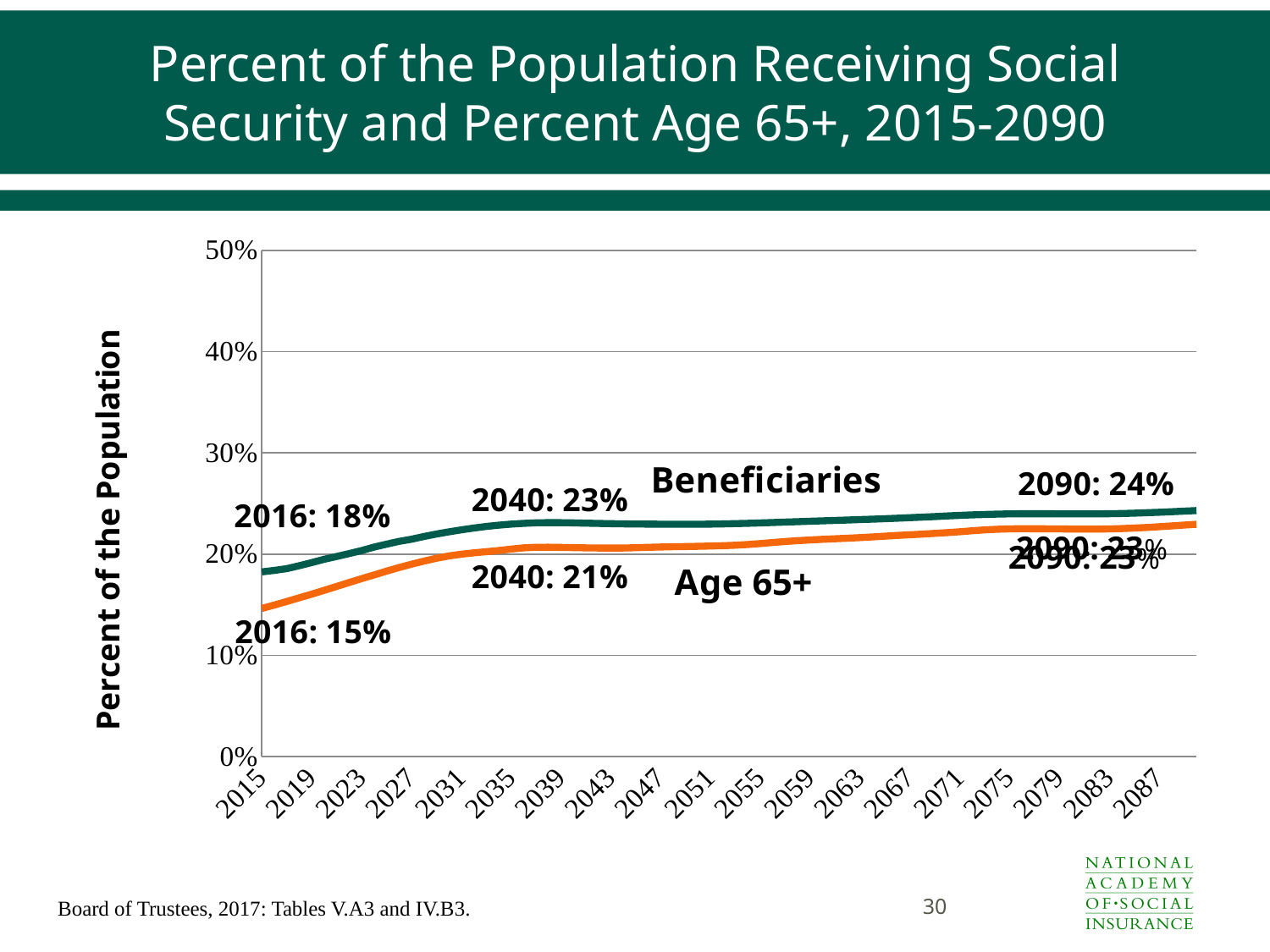
What kind of chart is shown on the slide? line chart What percent of the population was Age 65+ in 2016? 15% What percent of the population were Beneficiaries in 2016? 18% Is the value for Age 65+ in 2087 greater or less than 20%? greater What value is labeled for Beneficiaries in 2040? 23% By how many percentage points did Beneficiaries exceed Age 65+ in 2016? 3 percentage points Does the Beneficiaries line generally rise or fall from 2015 to 2090? rise By how many percentage points did Beneficiaries exceed Age 65+ in 2040? 2 percentage points What value is labeled for Age 65+ in 2040? 21% Is the value for Beneficiaries in 2015 greater or less than 20%? less In 2040, which series is higher, Beneficiaries or Age 65+? Beneficiaries What value is labeled for Beneficiaries in 2090? 24%